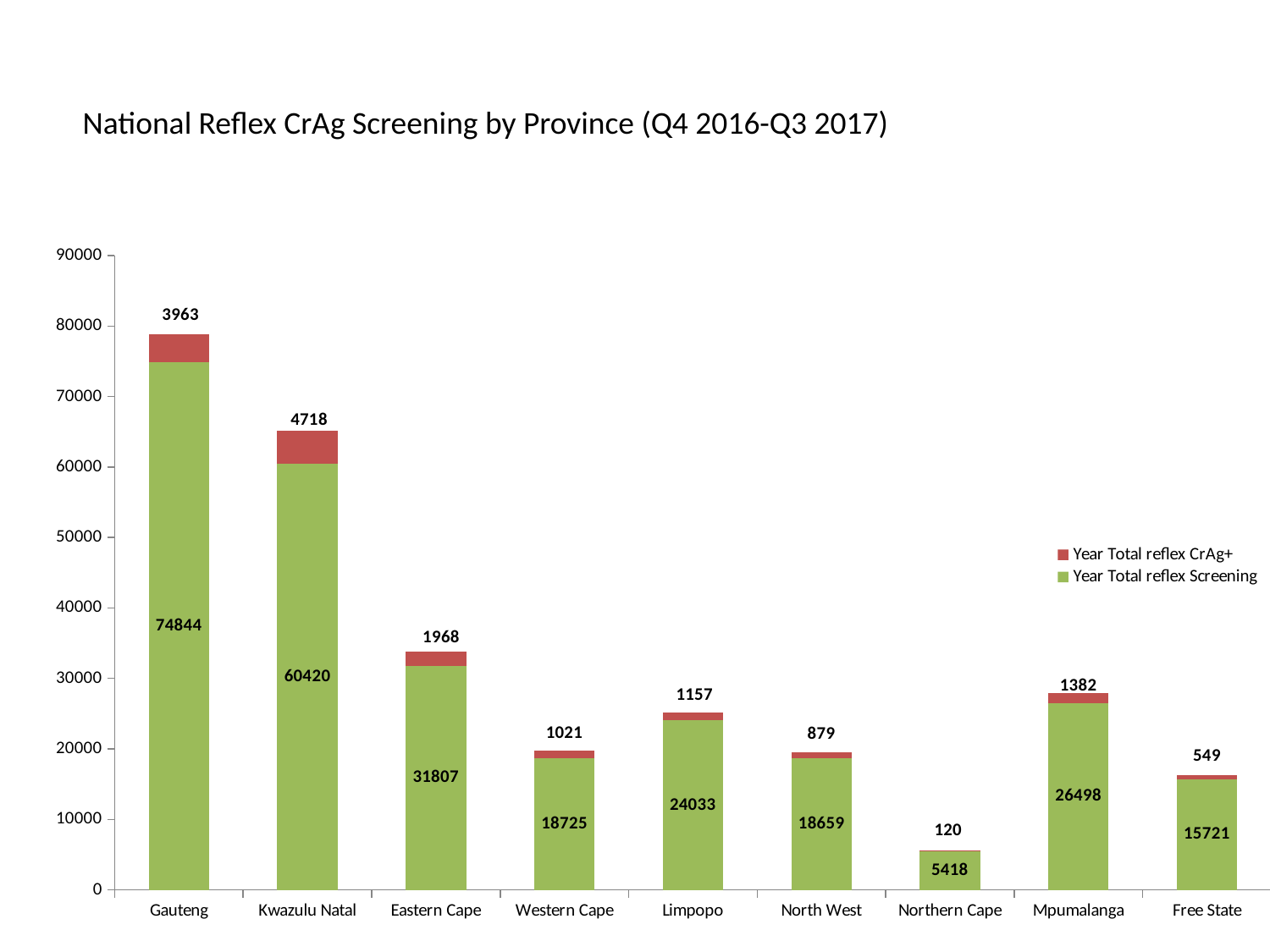
What is the Year Total reflex Screening value for Gauteng? 74844 What is the Year Total reflex CrAg+ value for Kwazulu Natal? 4718 What is the title of the chart? National Reflex CrAg Screening by Province (Q4 2016-Q3 2017) How many provinces are shown on the x axis? 9 Which province has the lowest Year Total reflex CrAg+ value? Northern Cape What kind of chart is shown on the slide? Stacked bar chart Which is larger, the Year Total reflex CrAg+ value for Gauteng or for Kwazulu Natal? Kwazulu Natal What is the total of the stacked bar for Eastern Cape? 33775 How many series does the legend list? 2 Which province has the highest Year Total reflex Screening value? Gauteng What is the Year Total reflex Screening value for Northern Cape? 5418 What is the difference between the Year Total reflex Screening values for Gauteng and Kwazulu Natal? 14424